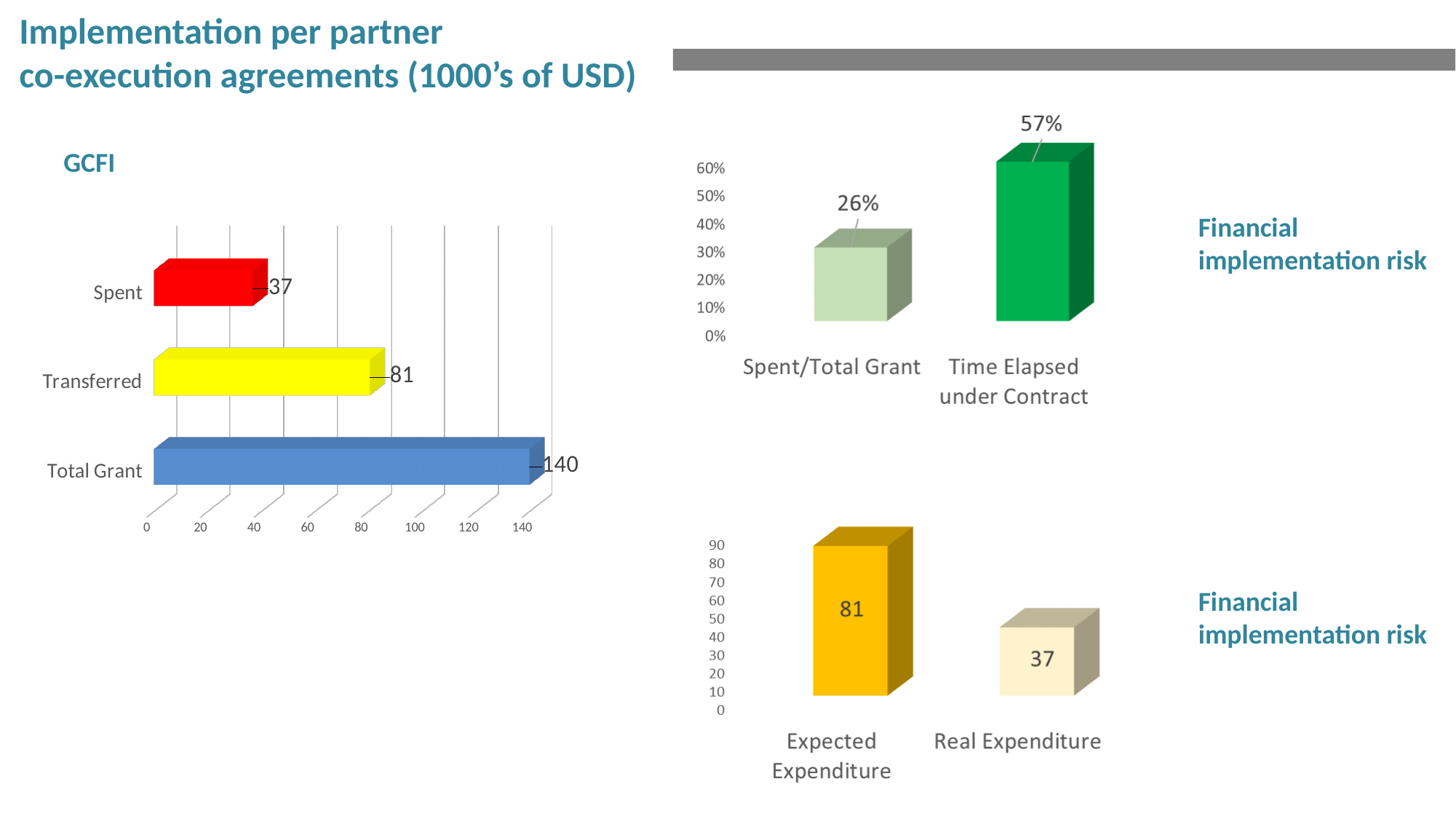
In the GCFI chart on the left, which category has the lowest value? Spent In the bottom-right chart, what is the difference between Expected Expenditure and Real Expenditure? 44 In the GCFI chart on the left, what is the value for Total Grant? 140 In the GCFI chart on the left, what is the value for Spent? 37 In the top-right chart, which is larger, Spent/Total Grant or Time Elapsed under Contract? Time Elapsed under Contract In the GCFI chart on the left, what is the value for Transferred? 81 What kind of chart is the GCFI chart on the left? Bar chart In the top-right chart, what is the value for Time Elapsed under Contract? 57% In the GCFI chart on the left, how many categories are shown? 3 In the bottom-right chart, what is the value for Expected Expenditure? 81 In the top-right chart, what is the value for Spent/Total Grant? 26% In the GCFI chart on the left, what is the difference between Total Grant and Transferred? 59